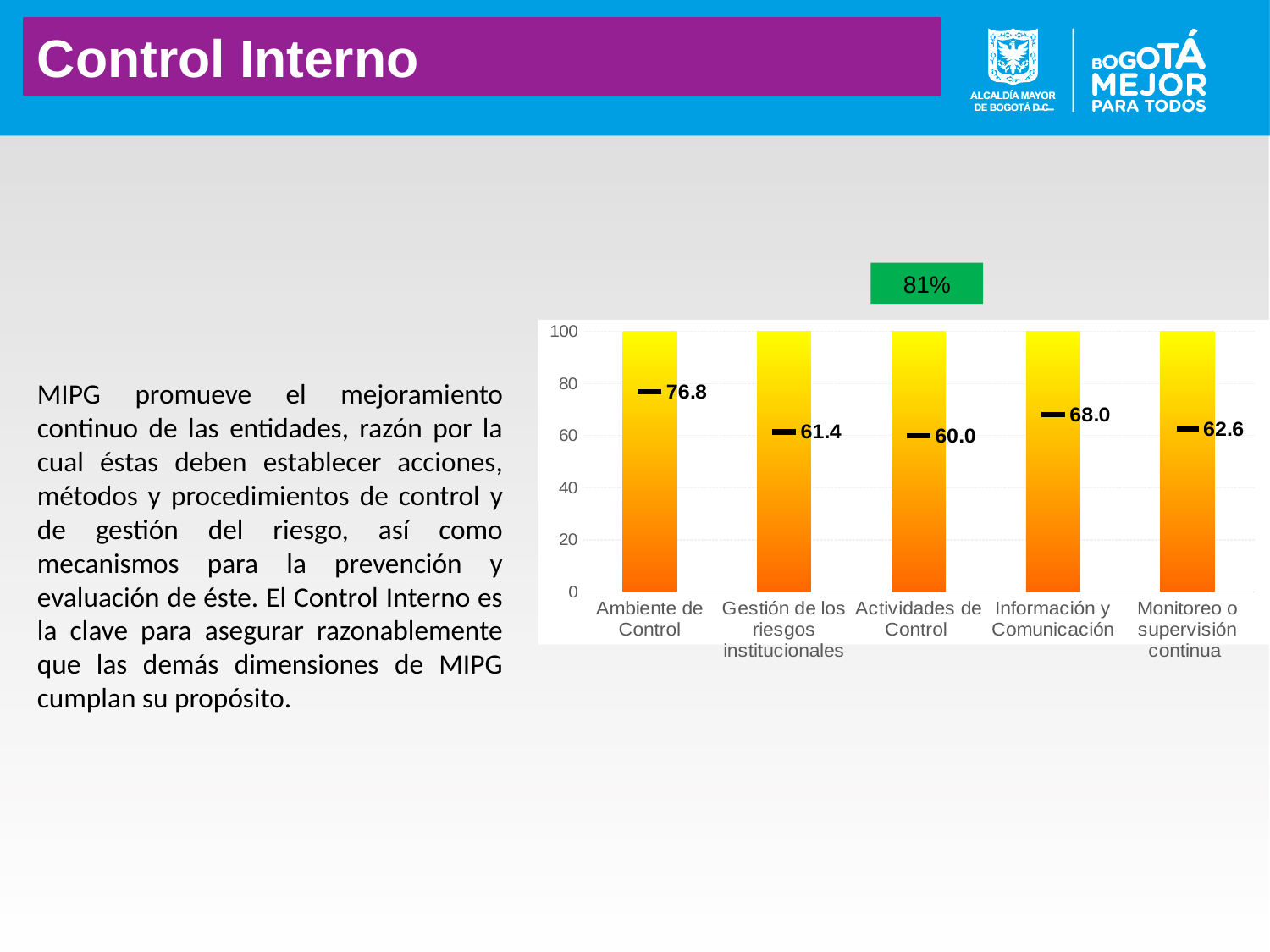
What kind of chart is shown on the slide? Bar chart What is the value marked for Monitoreo o supervisión continua? 62.6 What is the difference between the values for Ambiente de Control and Actividades de Control? 16.8 What is the value marked for Gestión de los riesgos institucionales? 61.4 How many categories are shown on the x axis of the chart? 5 What is the value marked for Ambiente de Control? 76.8 Which category has the lowest marked value? Actividades de Control Which is larger, the value for Información y Comunicación or the value for Monitoreo o supervisión continua? Información y Comunicación What percentage is shown in the green box above the chart? 81% Which category has the highest marked value? Ambiente de Control What is the difference between the values for Información y Comunicación and Gestión de los riesgos institucionales? 6.6 What is the value marked for Información y Comunicación? 68.0